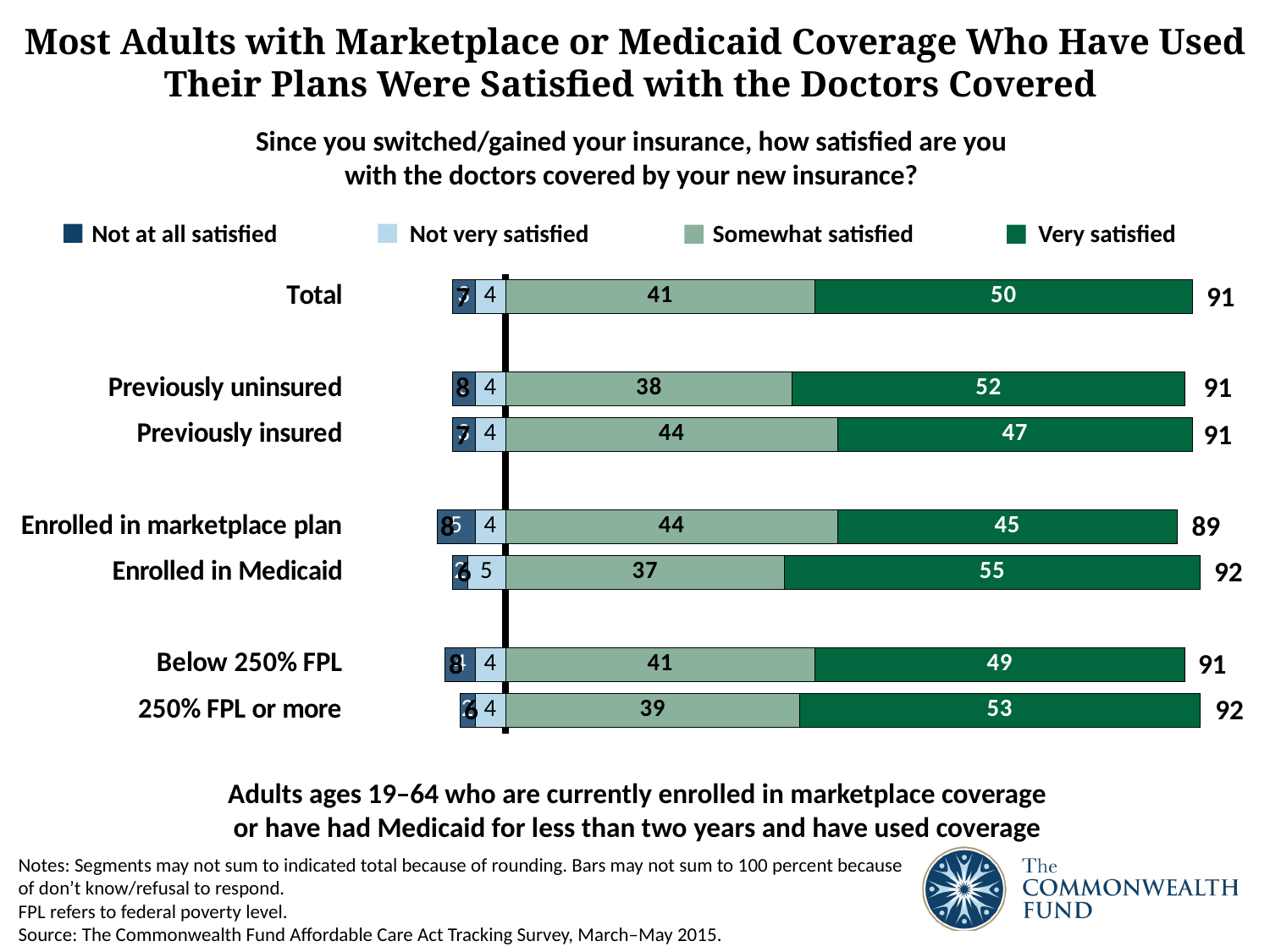
How many categories (bars) are plotted in the chart? 7 Which category has the highest Very satisfied value? Enrolled in Medicaid What is the Not very satisfied value for Enrolled in Medicaid? 5 Which category has the lowest Very satisfied value? Enrolled in marketplace plan Which has the larger Somewhat satisfied value, Previously insured or Previously uninsured? Previously insured How many series does the legend list? 4 What is the difference between the Very satisfied values for Previously uninsured and Previously insured? 5 What colour represents Very satisfied in the legend? Dark green What is the Somewhat satisfied value for Enrolled in Medicaid? 37 What kind of chart is shown on the slide? Stacked bar chart What number is printed at the end of the bar for Enrolled in marketplace plan? 89 What is the Very satisfied value for the Total bar? 50